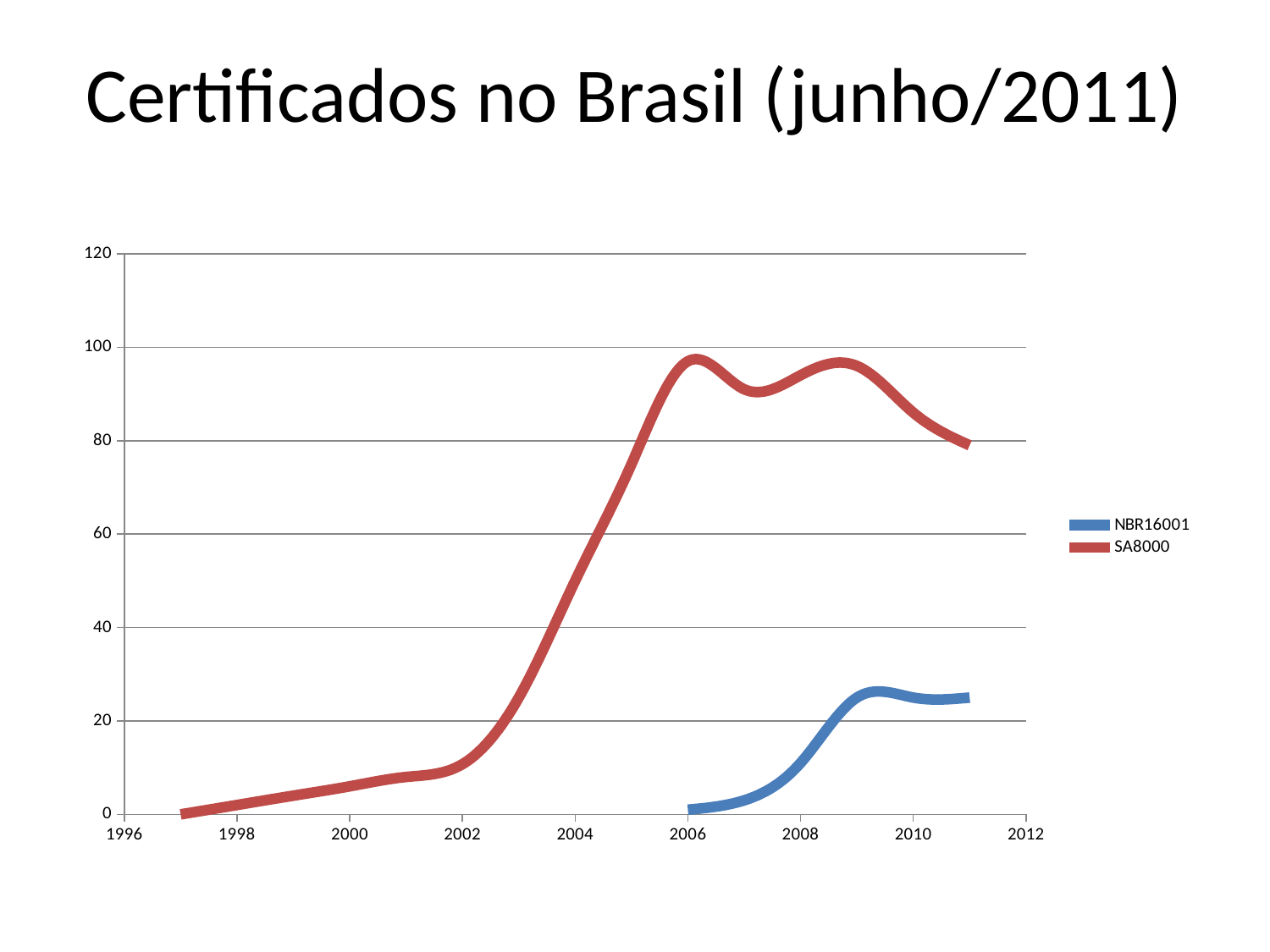
Is the value for SA8000 in 2005 greater or less than 60? greater Does the SA8000 line rise or fall between 1997 and 2006? rise What are the two series named in the legend? NBR16001 and SA8000 Is the value for NBR16001 in 2011 greater or less than 40? less What is the title of the slide containing the chart? Certificados no Brasil (junho/2011) What kind of chart is shown on the slide? line chart Is the value for SA8000 in 2002 greater or less than 20? less In 2010, which series has the larger value, SA8000 or NBR16001? SA8000 Does the SA8000 line rise or fall between 2009 and 2011? fall How many series does the legend list? 2